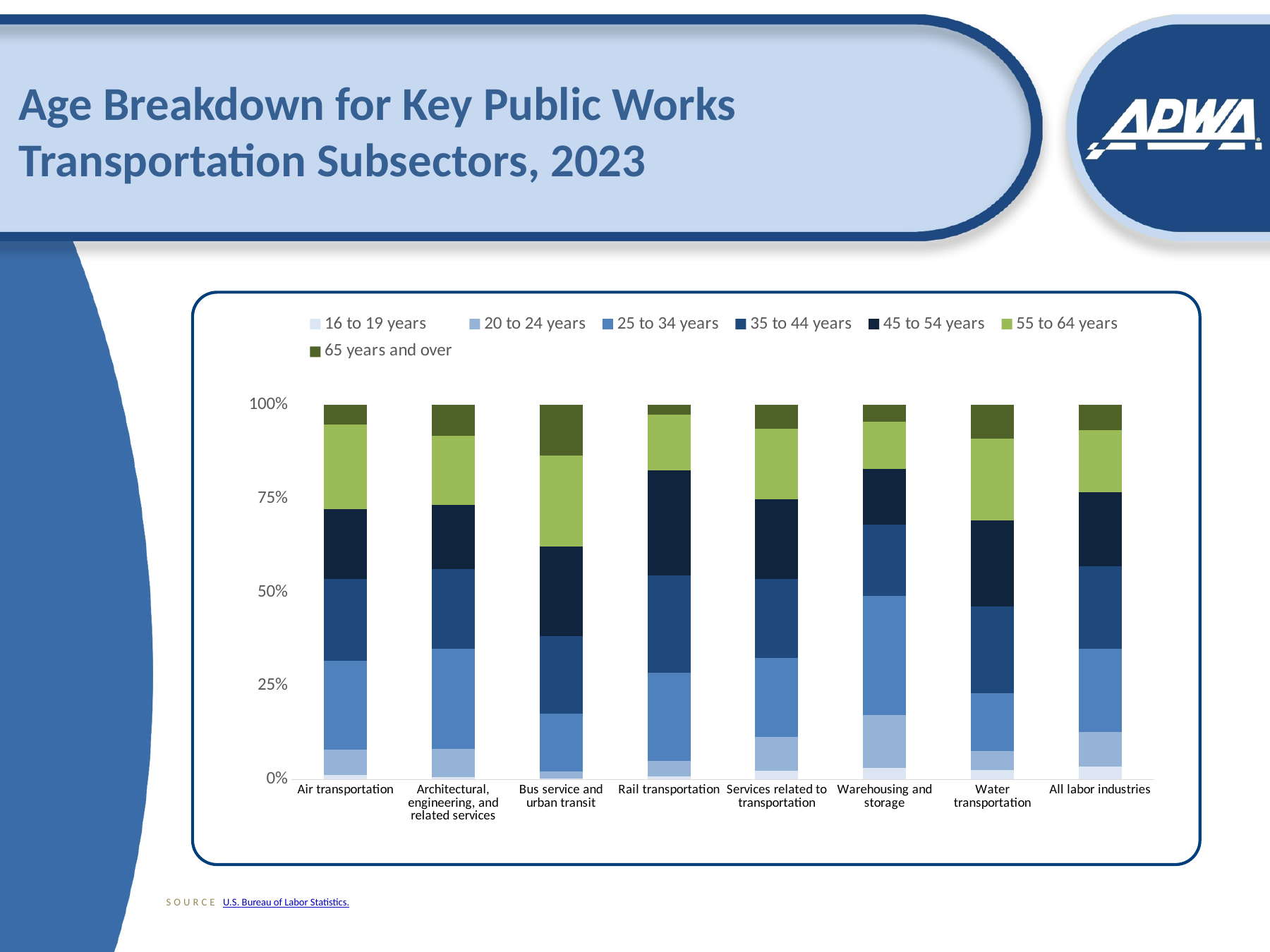
Which category has the largest 65 years and over segment? Bus service and urban transit Is the 25 to 34 years segment larger for Warehousing and storage or for Water transportation? Warehousing and storage What kind of chart is shown on the slide? Stacked bar chart What is the title of the slide's chart? Age Breakdown for Key Public Works Transportation Subsectors, 2023 Which category has the smallest 65 years and over segment? Rail transportation How many age groups does the legend list? 7 How many industry categories are shown along the x axis? 8 Is the 65 years and over segment larger for Bus service and urban transit or for Rail transportation? Bus service and urban transit Is the 25 to 34 years segment for Water transportation greater or less than 25%? less Is the 25 to 34 years segment for Warehousing and storage greater or less than 25%? greater Which age group is the last entry in the legend? 65 years and over Which category has the largest 25 to 34 years segment? Warehousing and storage